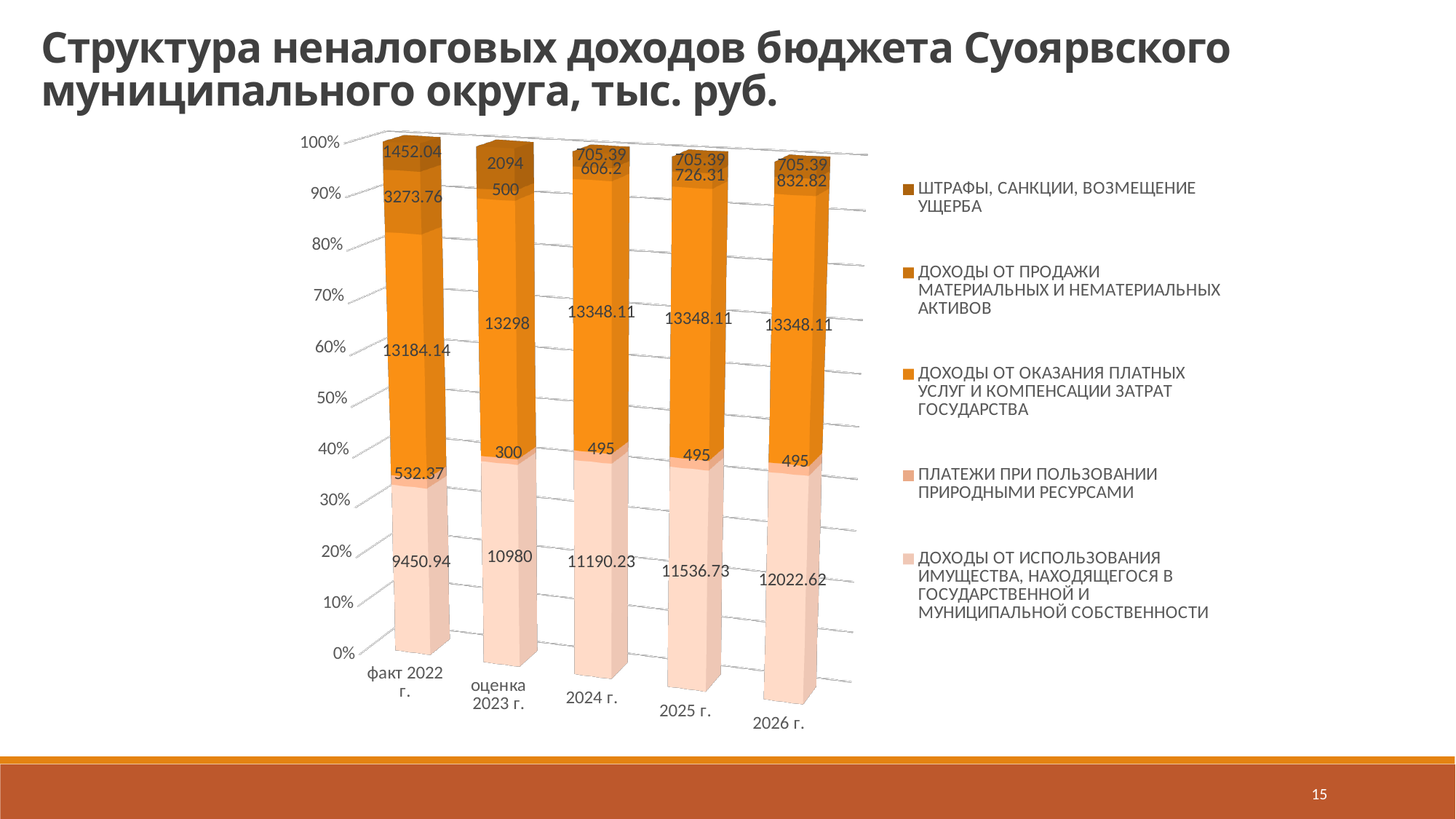
Does the value for ДОХОДЫ ОТ ИСПОЛЬЗОВАНИЯ ИМУЩЕСТВА rise or fall from факт 2022 г. to 2026 г.? rise What is the value for ДОХОДЫ ОТ ПРОДАЖИ МАТЕРИАЛЬНЫХ И НЕМАТЕРИАЛЬНЫХ АКТИВОВ in 2025 г.? 726.31 In which year is the value for ПЛАТЕЖИ ПРИ ПОЛЬЗОВАНИИ ПРИРОДНЫМИ РЕСУРСАМИ the lowest? оценка 2023 г. In which year is the value for ШТРАФЫ, САНКЦИИ, ВОЗМЕЩЕНИЕ УЩЕРБА the highest? оценка 2023 г. Which is larger: ДОХОДЫ ОТ ПРОДАЖИ МАТЕРИАЛЬНЫХ И НЕМАТЕРИАЛЬНЫХ АКТИВОВ in факт 2022 г. or in оценка 2023 г.? факт 2022 г. What is the value for ШТРАФЫ, САНКЦИИ, ВОЗМЕЩЕНИЕ УЩЕРБА in оценка 2023 г.? 2094 How many series does the legend list? 5 How many years (categories) are shown on the x axis? 5 What kind of chart is shown on the slide? 100% stacked bar chart What is the value for ДОХОДЫ ОТ ИСПОЛЬЗОВАНИЯ ИМУЩЕСТВА in факт 2022 г.? 9450.94 What is the difference between the ДОХОДЫ ОТ ИСПОЛЬЗОВАНИЯ ИМУЩЕСТВА values for 2026 г. and факт 2022 г.? 2571.68 What is the value for ПЛАТЕЖИ ПРИ ПОЛЬЗОВАНИИ ПРИРОДНЫМИ РЕСУРСАМИ in 2026 г.? 495